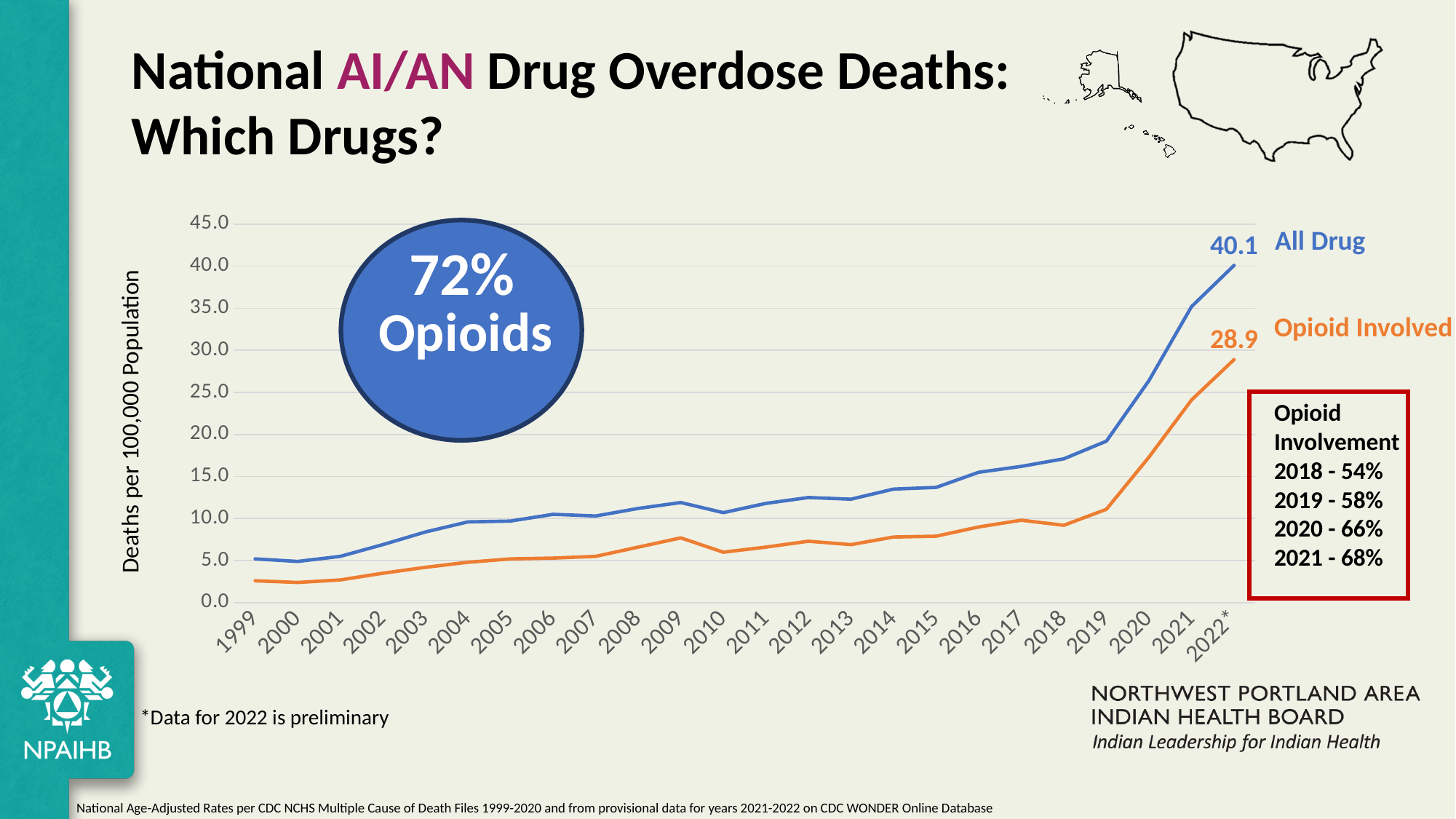
Is the Opioid Involved value for 2009 greater or less than 10.0? less What is the label on the y axis? Deaths per 100,000 Population How many series are plotted on the chart? 2 Is the All Drug value for 2021 greater or less than 30.0? greater In 2022*, which series has the higher value, All Drug or Opioid Involved? All Drug How many years are shown on the x axis? 24 Do the All Drug values generally rise or fall from 1999 to 2022*? Rise Is the All Drug value for 2019 greater or less than 15.0? greater What is the All Drug death rate for 2022*? 40.1 What type of chart is shown on the slide? Line chart What is the Opioid Involved death rate for 2022*? 28.9 What is the difference between the All Drug and Opioid Involved rates in 2022*? 11.2